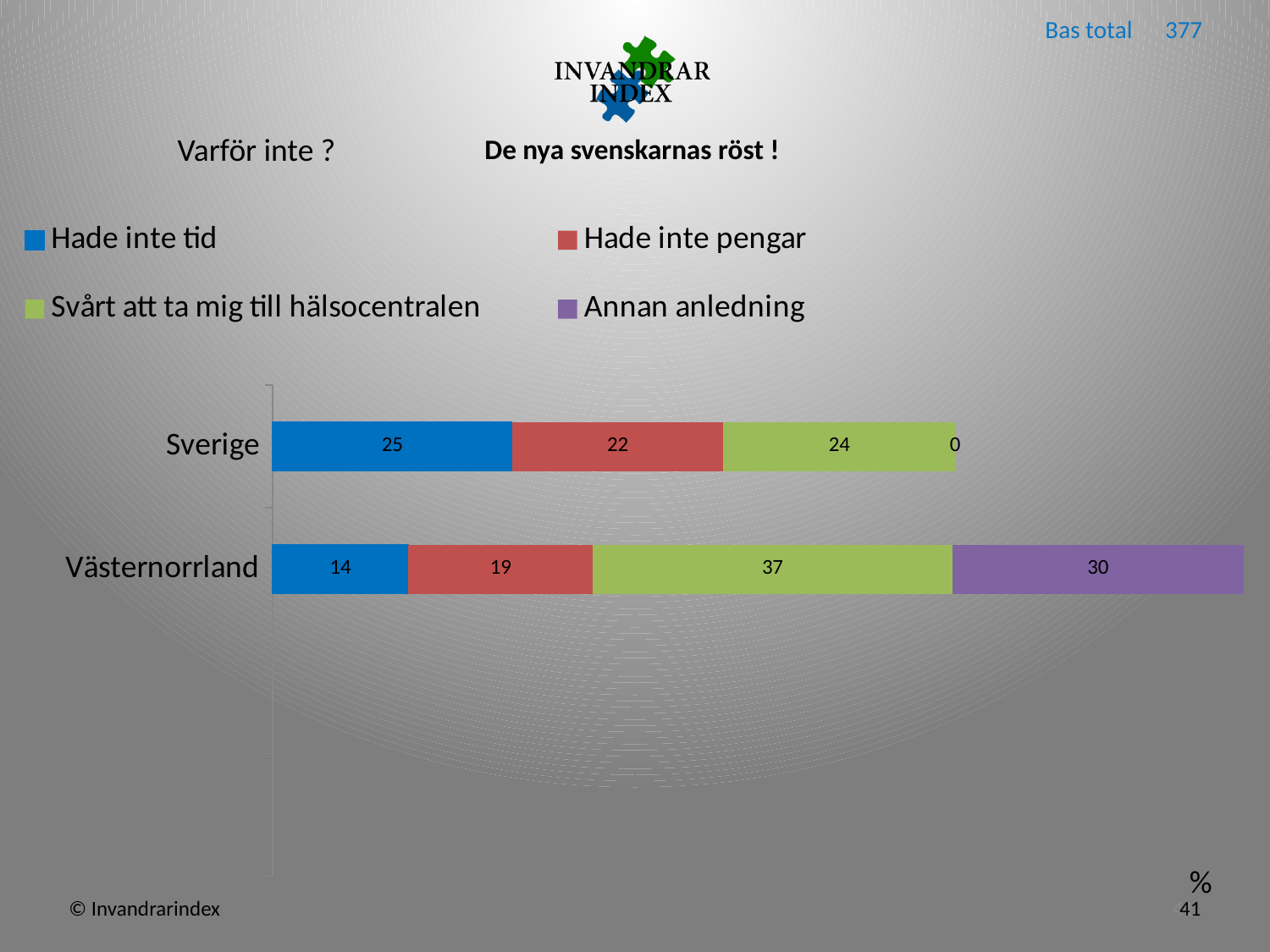
What kind of chart is shown on the slide? Stacked bar chart What is the value for "Svårt att ta mig till hälsocentralen" for Västernorrland? 37 Which is larger: "Hade inte pengar" for Sverige or for Västernorrland? Sverige What is the value for "Annan anledning" for Sverige? 0 Which series has the highest value for Västernorrland? Svårt att ta mig till hälsocentralen What is the total of the stacked bar for Västernorrland? 100 How many series does the legend list? 4 Which series has the lowest value for Sverige? Annan anledning What is the difference between the "Hade inte tid" values for Sverige and Västernorrland? 11 What is the value for "Hade inte tid" for Sverige? 25 How many categories are shown on the chart? 2 What is the value for "Hade inte pengar" for Västernorrland? 19